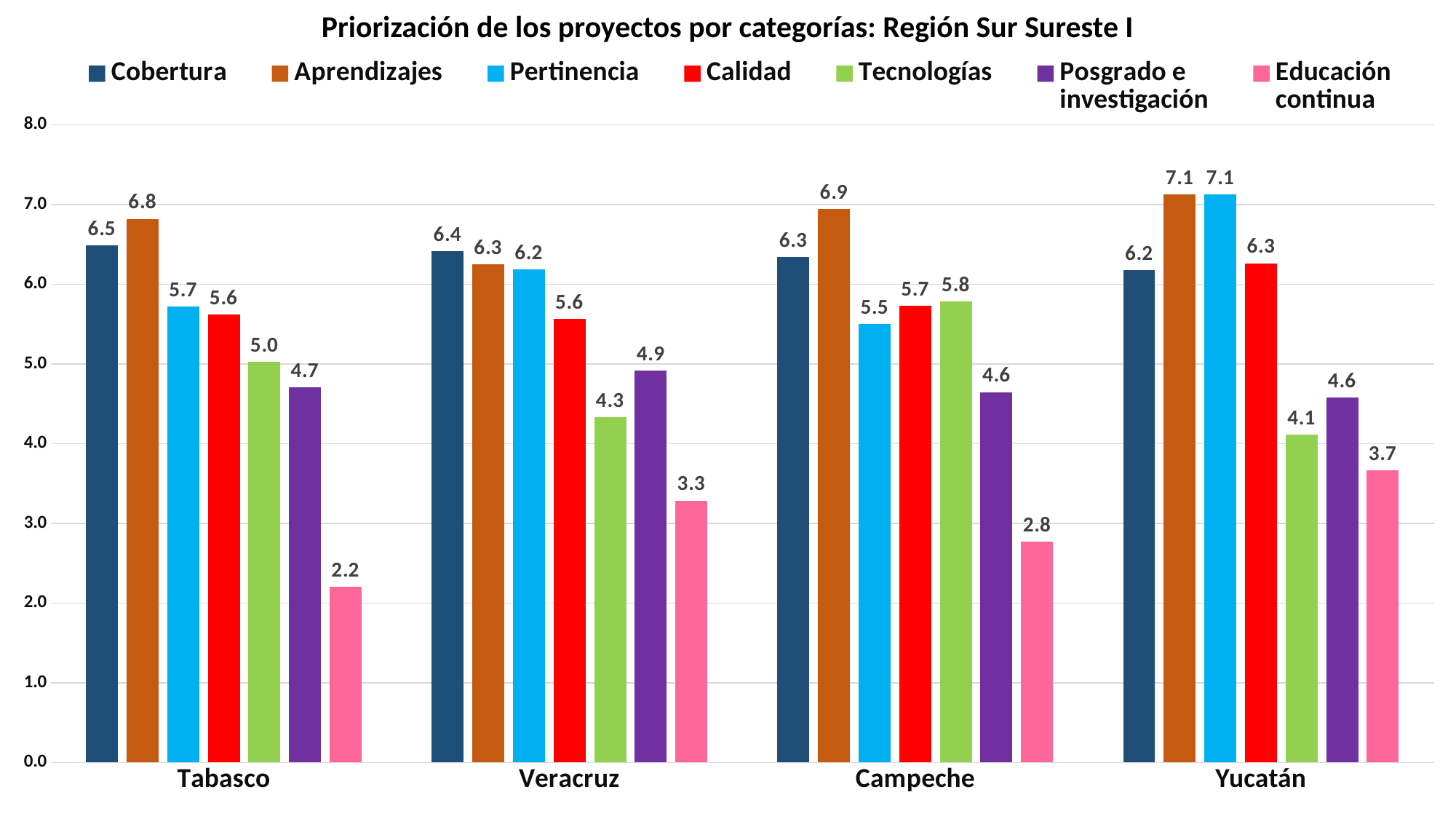
What is the title of the chart? Priorización de los proyectos por categorías: Región Sur Sureste I What is the value for Aprendizajes in Tabasco? 6.8 What kind of chart is this? Bar chart Does the value for Educación continua rise or fall from Tabasco to Veracruz? Rise Which category has the highest value in Campeche? Aprendizajes How many series does the legend list? 7 What is the value for Educación continua in Campeche? 2.8 What is the difference between Cobertura and Educación continua in Tabasco? 4.3 What is the value for Tecnologías in Yucatán? 4.1 Which category has the lowest value in Veracruz? Educación continua How many regions are shown on the x axis? 4 Which is larger in Veracruz, Tecnologías or Posgrado e investigación? Posgrado e investigación